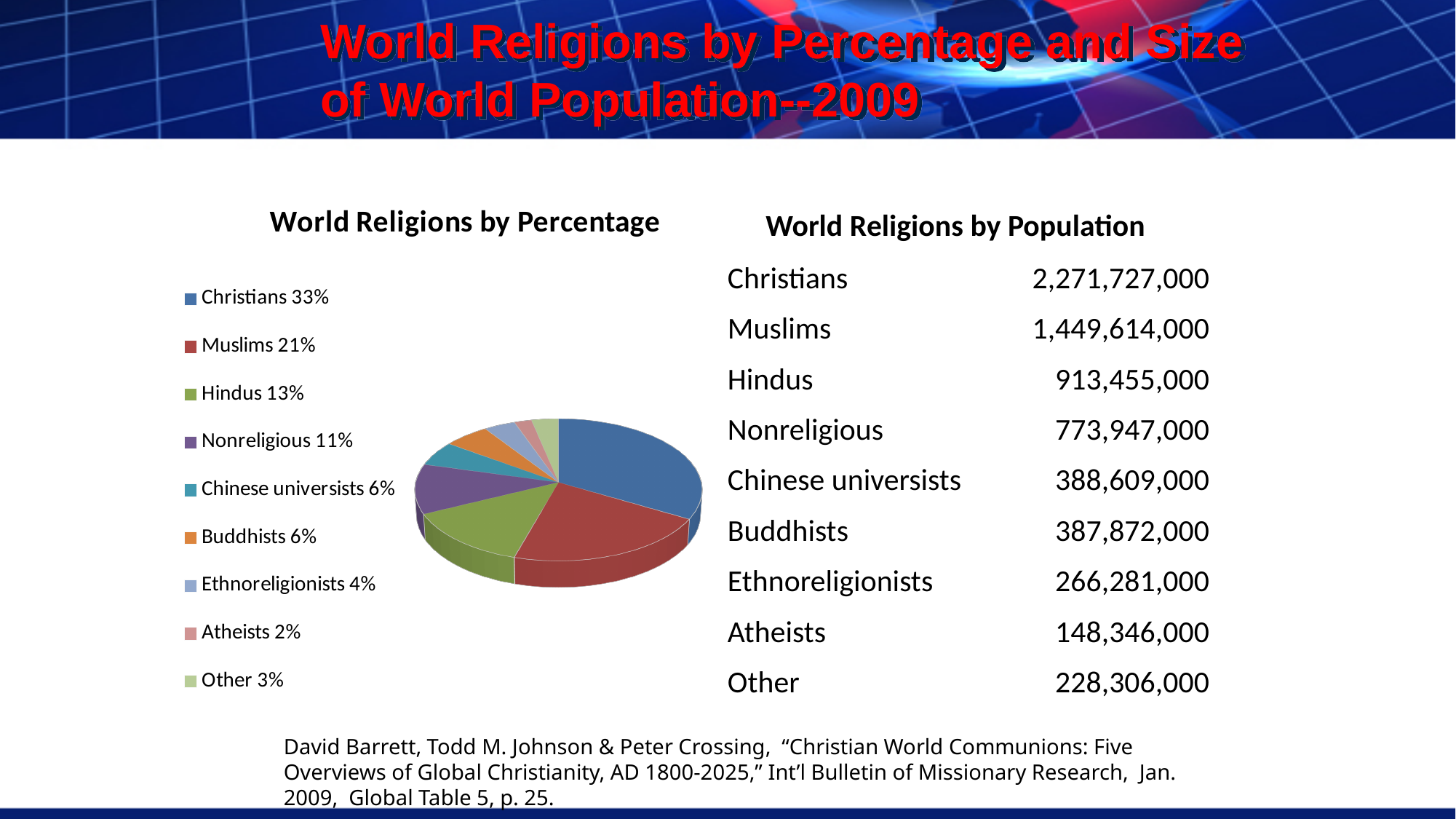
How many categories does the "World Religions by Percentage" pie chart show? 9 In the "World Religions by Percentage" pie chart, what is the combined percentage of Chinese universists and Buddhists? 12% In the "World Religions by Percentage" pie chart, which category has the smallest slice? Atheists In the "World Religions by Percentage" pie chart, which is larger, the slice for Nonreligious or the slice for Hindus? Hindus In the "World Religions by Percentage" pie chart, what colour is the Christians slice? Blue In the "World Religions by Percentage" pie chart, what is the difference in percentage points between Christians and Muslims? 12 In the "World Religions by Percentage" pie chart, what percentage is shown for Ethnoreligionists? 4% In the "World Religions by Percentage" pie chart, what percentage is shown for Hindus? 13% In the "World Religions by Percentage" pie chart, what percentage is shown for Christians? 33% In the "World Religions by Percentage" pie chart, which category has the largest slice? Christians What kind of chart is shown under the title "World Religions by Percentage"? Pie chart In the "World Religions by Percentage" pie chart, what share of the pie do Muslims represent? 21%